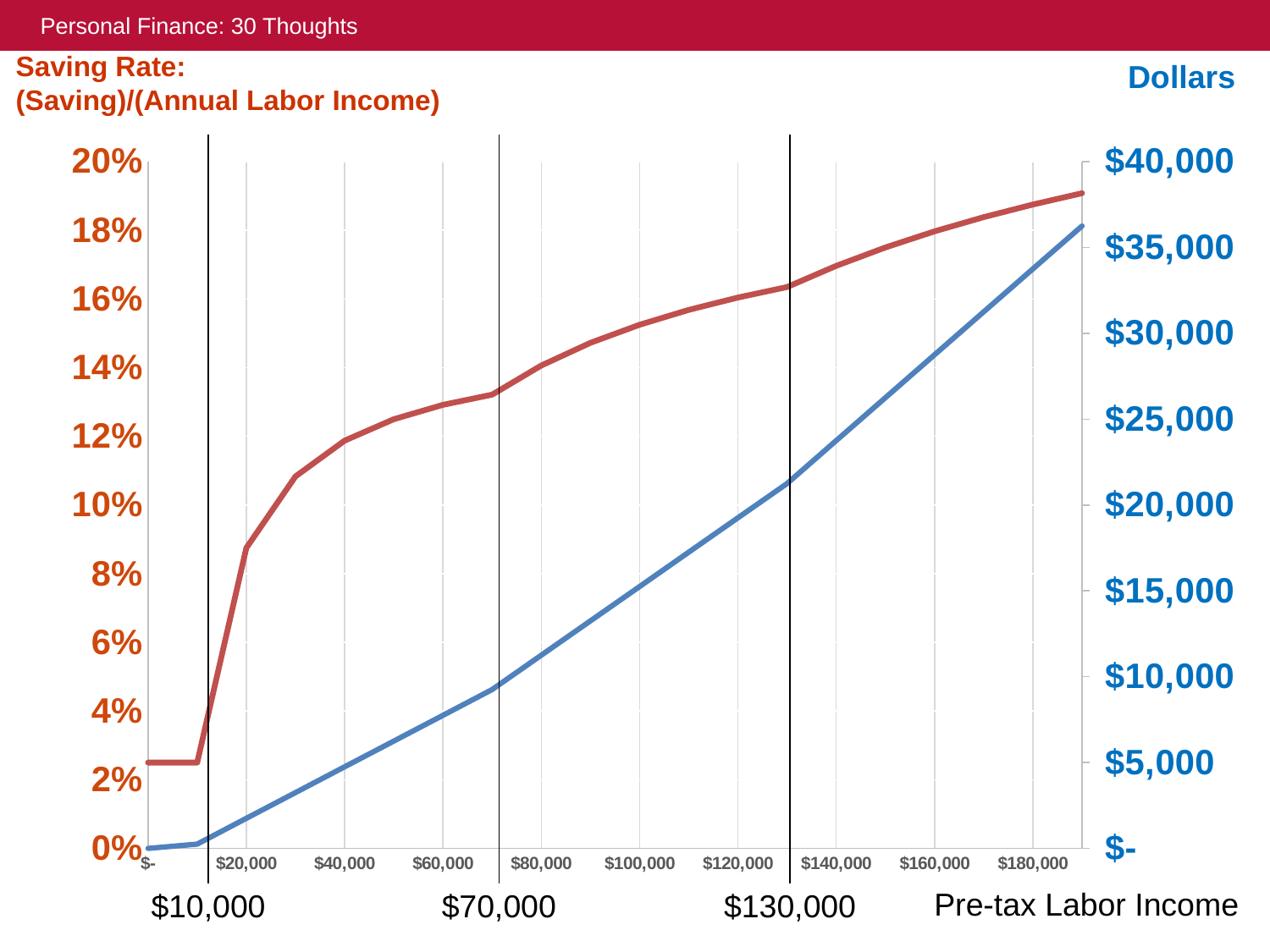
Is the dollars value (blue line) at $60,000 of pre-tax labor income greater or less than $10,000? less Is the saving rate at $100,000 of pre-tax labor income greater or less than 14%? greater Is the dollars value (blue line) at $140,000 of pre-tax labor income greater or less than $20,000? greater What is the title of the left vertical axis? Saving Rate: (Saving)/(Annual Labor Income) Is the saving rate larger at $40,000 or at $20,000 of pre-tax labor income? $40,000 What kind of chart is shown on the slide? line chart What is the title of the horizontal axis? Pre-tax Labor Income Does the dollars series (blue line) rise or fall as pre-tax labor income increases? rise Does the saving rate (red line) rise or fall as pre-tax labor income increases? rise